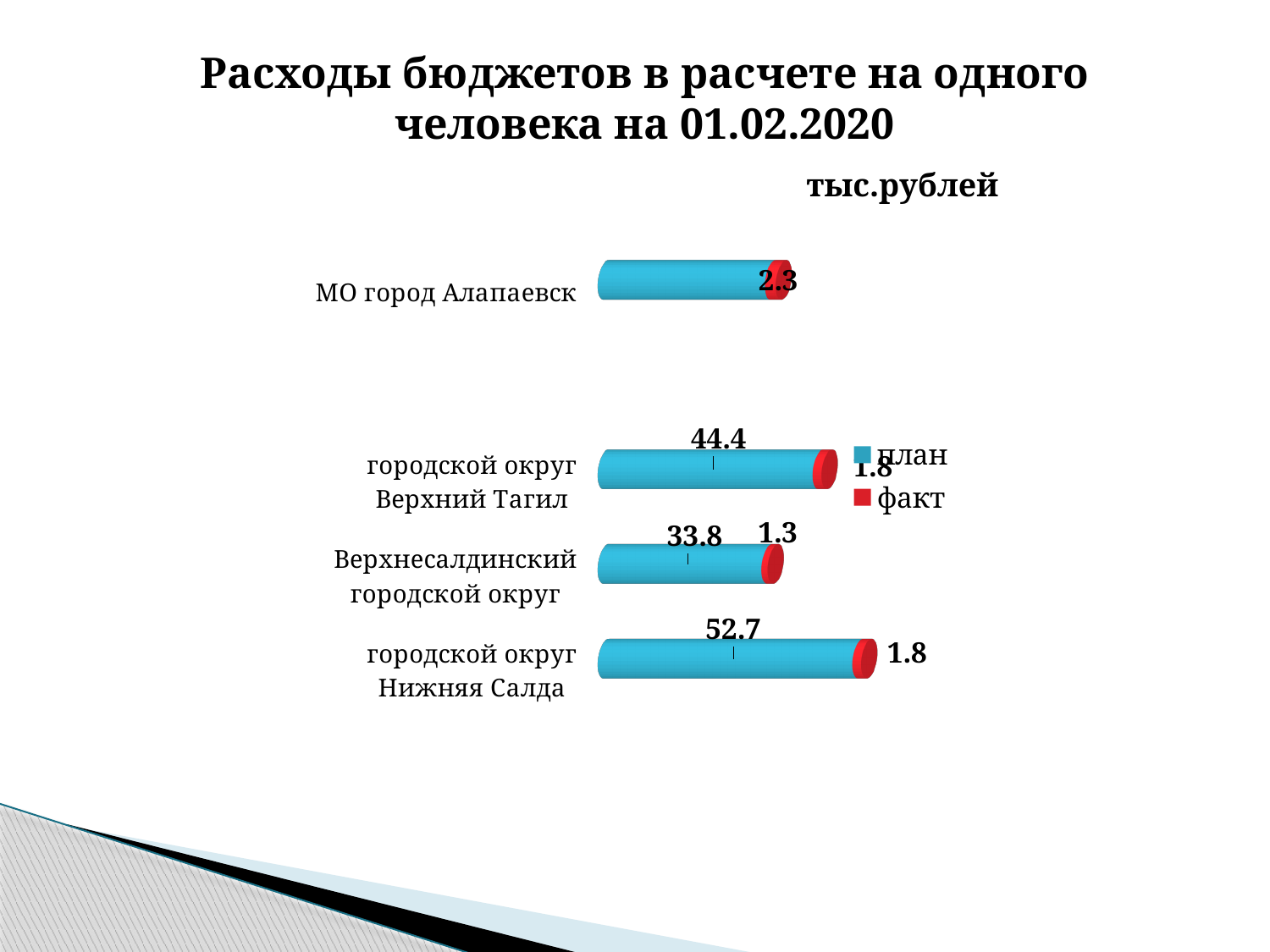
What is the difference between the план values for городской округ Нижняя Салда and городской округ Верхний Тагил? 8.3 How many series does the legend list? 2 What is the план value for Верхнесалдинский городской округ? 33.8 What kind of chart is shown on the slide? bar chart Which category has the highest план value? городской округ Нижняя Салда What is the факт value for МО город Алапаевск? 2.3 What is the факт value for Верхнесалдинский городской округ? 1.3 What is the план value for городской округ Нижняя Салда? 52.7 What unit of measurement is indicated for the chart? тыс.рублей Which is larger, the план value for городской округ Верхний Тагил or for Верхнесалдинский городской округ? городской округ Верхний Тагил How many categories are shown in the chart? 4 Which category has the lowest факт value? Верхнесалдинский городской округ